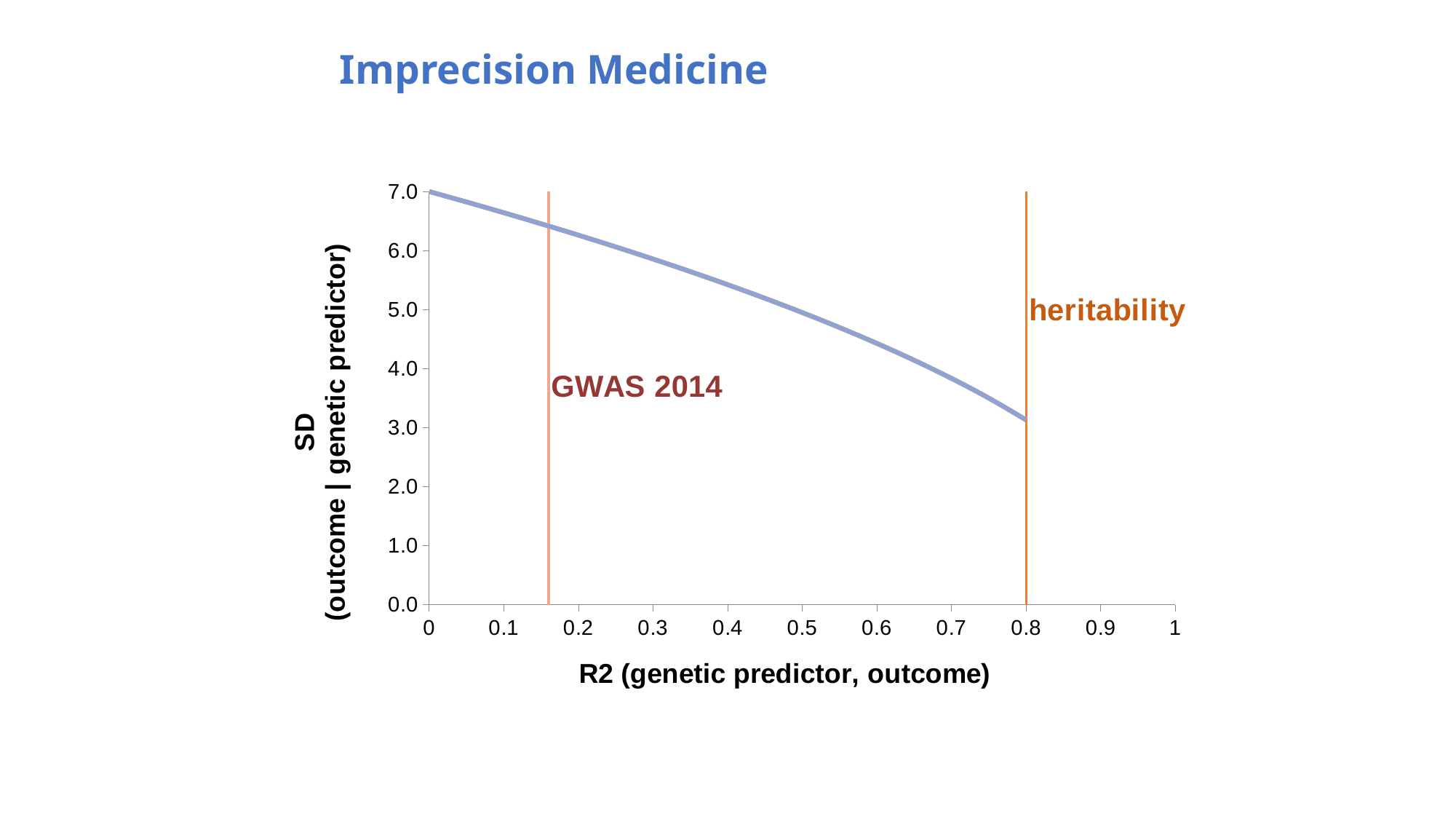
Does the SD value rise or fall as R2 increases along the x axis? fall What is the title of the slide containing the chart? Imprecision Medicine What is the label of the x axis? R2 (genetic predictor, outcome) Is the SD value of the curve at the GWAS 2014 line greater or less than 6.0? greater Which is larger, the SD value at R2 = 0 or the SD value at R2 = 0.8? R2 = 0 At which R2 value is the vertical line labelled 'heritability' drawn? 0.8 Is the vertical line labelled 'GWAS 2014' at an R2 value greater or less than 0.2? less Is the SD value of the curve at R2 = 0.8 greater or less than 4.0? less What kind of chart is shown on the slide? line chart What is the SD value of the curve at R2 = 0? 7.0